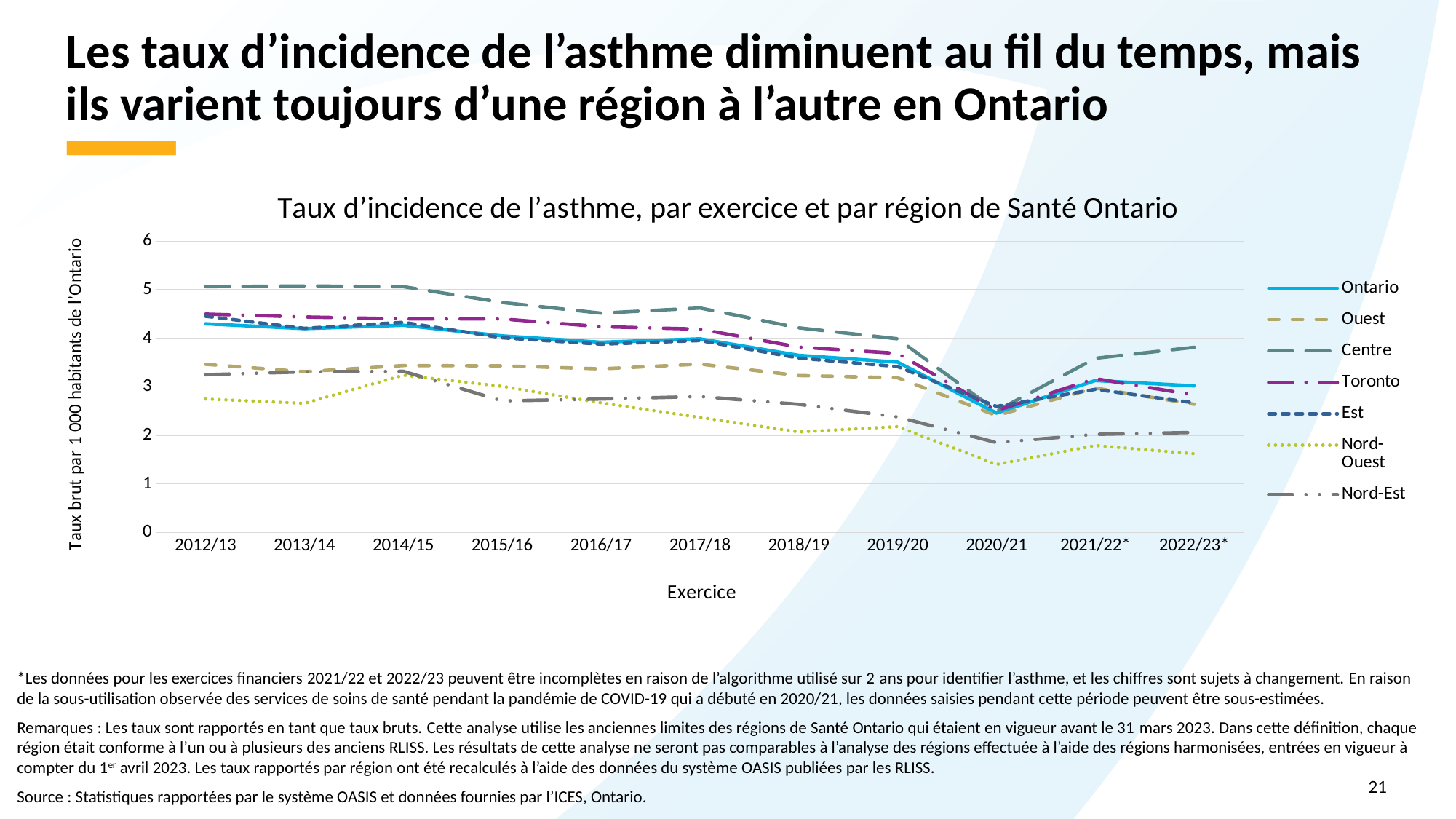
Which is larger in 2017/18, the value for Centre or the value for Nord-Ouest? Centre Which region has the lowest asthma incidence rate in 2012/13? Nord-Ouest What kind of chart is shown on the slide? line chart Is the value for Centre in 2022/23* greater or less than 3? greater Which region has the highest asthma incidence rate in 2022/23*? Centre Is the value for Ontario in 2020/21 greater or less than 3? less Is the value for Nord-Ouest in 2020/21 greater or less than 2? less Does the Ontario line rise or fall from 2012/13 to 2020/21? fall How many fiscal years (exercices) are shown on the x axis? 11 Which region has the lowest asthma incidence rate in 2020/21? Nord-Ouest How many series does the legend list? 7 Which region has the highest asthma incidence rate in 2012/13? Centre